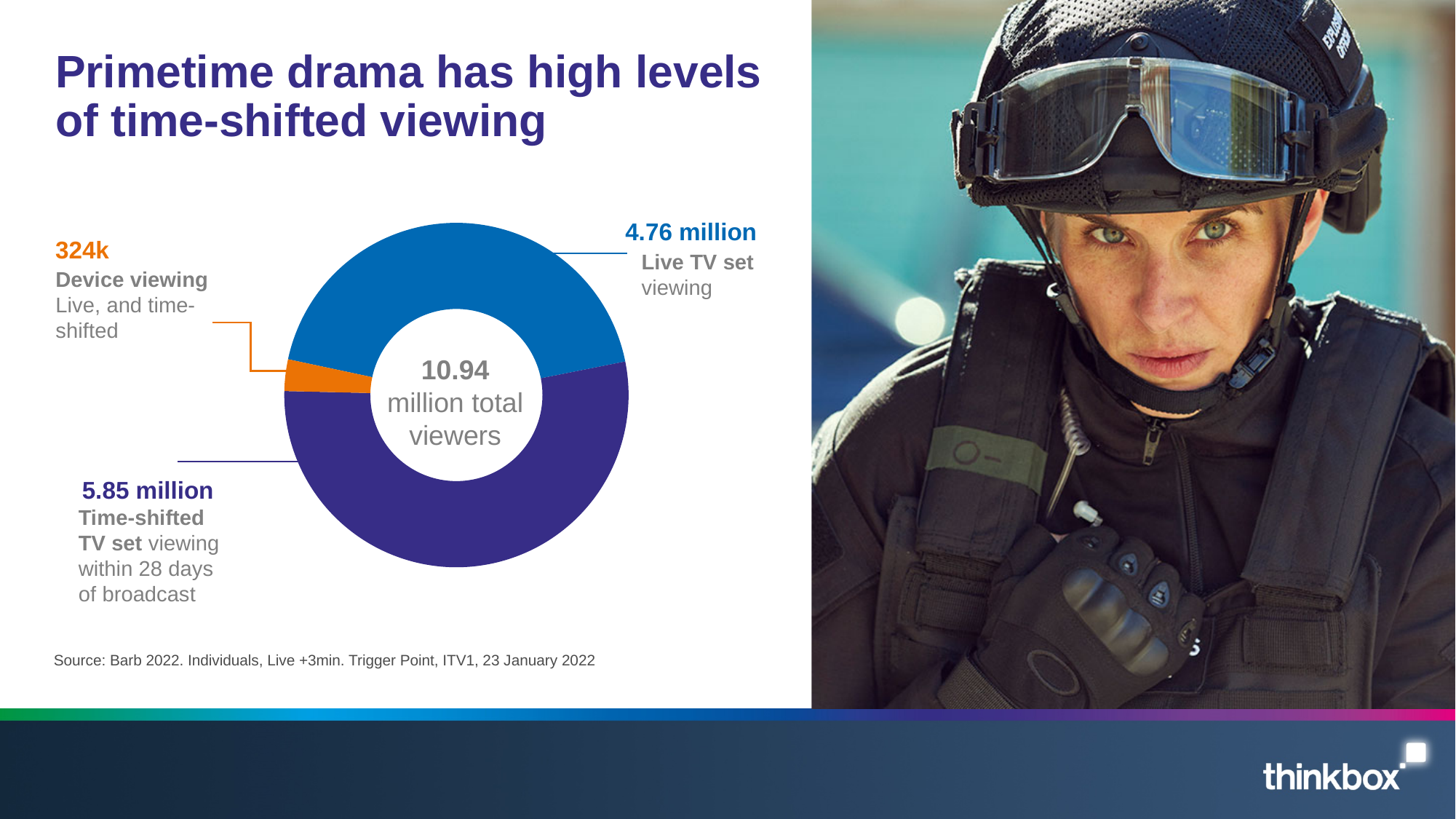
How many segments does the chart have? 3 Which segment of the chart is the largest? Time-shifted TV set viewing What kind of chart is shown on the slide? Pie chart (donut) Which segment of the chart is the smallest? Device viewing What is the total number of viewers shown in the centre of the chart? 10.94 million What is the title of the slide? Primetime drama has high levels of time-shifted viewing What is the value for Live TV set viewing? 4.76 million What colour is the Device viewing segment? Orange What is the value for Time-shifted TV set viewing within 28 days of broadcast? 5.85 million What is the difference between Time-shifted TV set viewing and Live TV set viewing? 1.09 million What is the value for Device viewing (live and time-shifted)? 324k Which is larger, Live TV set viewing or Time-shifted TV set viewing? Time-shifted TV set viewing